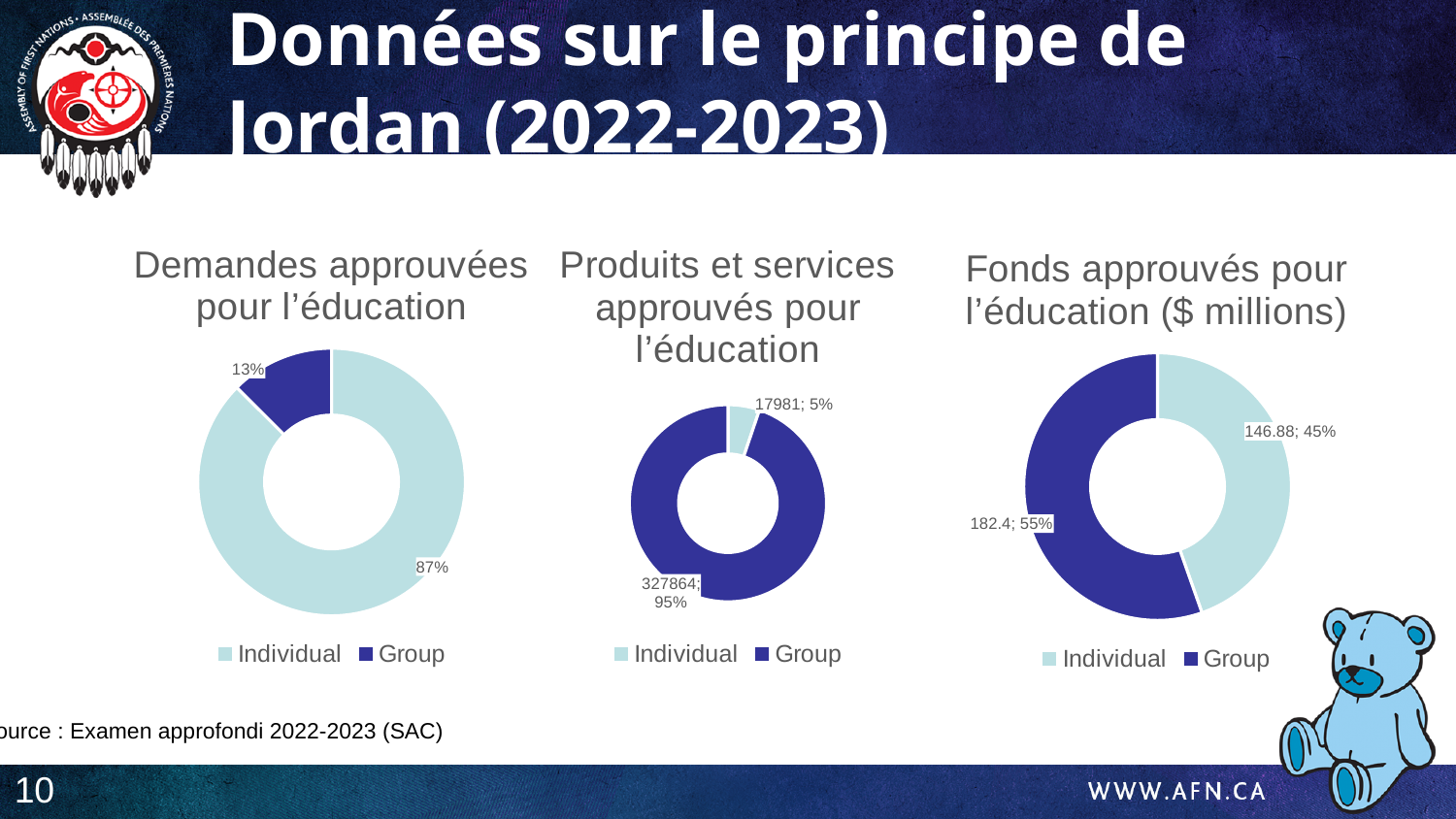
In the 'Fonds approuvés pour l'éducation ($ millions)' chart, what is the value for Group? 182.4 How many entries does the legend of the 'Fonds approuvés pour l'éducation ($ millions)' chart list? 2 In the 'Fonds approuvés pour l'éducation ($ millions)' chart, what is the value for Individual? 146.88 In the 'Fonds approuvés pour l'éducation ($ millions)' chart, what is the difference between Group and Individual? 35.52 In the 'Demandes approuvées pour l'éducation' chart, what share is Individual? 87% What kind of chart is used for 'Demandes approuvées pour l'éducation'? Doughnut chart In the 'Produits et services approuvés pour l'éducation' chart, what is the difference between Group and Individual? 309883 In the 'Produits et services approuvés pour l'éducation' chart, what is the value for Group? 327864 In the 'Produits et services approuvés pour l'éducation' chart, what share is Group? 95% In the 'Fonds approuvés pour l'éducation ($ millions)' chart, which category is larger, Individual or Group? Group In the 'Demandes approuvées pour l'éducation' chart, what share is Group? 13% In the 'Produits et services approuvés pour l'éducation' chart, what is the value for Individual? 17981